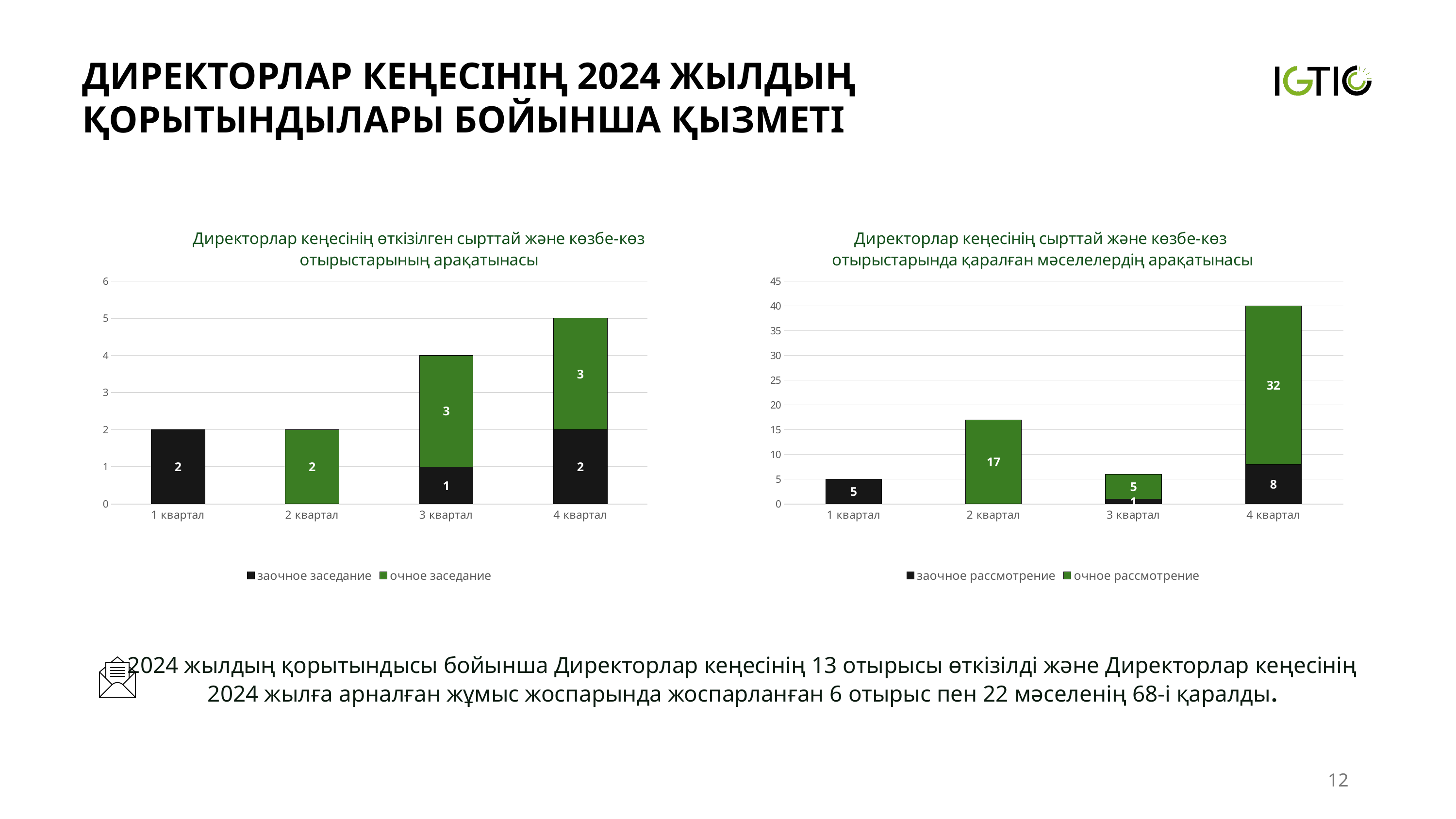
In the left chart, what is the total of the stacked bar for 4 квартал? 5 In the right chart, how many quarters are shown on the x axis? 4 In the right chart, what is the difference between очное рассмотрение in 4 квартал and in 2 квартал? 15 In the right chart, what is the value for очное рассмотрение in 2 квартал? 17 In the right chart, what is the total of the stacked bar for 4 квартал? 40 What type of chart is the right chart? Stacked bar chart In the right chart, which quarter has the lowest total stacked bar? 1 квартал In the left chart, what is the value for очное заседание in 3 квартал? 3 In the left chart, which quarter has the highest total stacked bar? 4 квартал In the left chart, what is the value for заочное заседание in 4 квартал? 2 In the right chart, what is the value for заочное рассмотрение in 4 квартал? 8 In the left chart, how many series does the legend list? 2